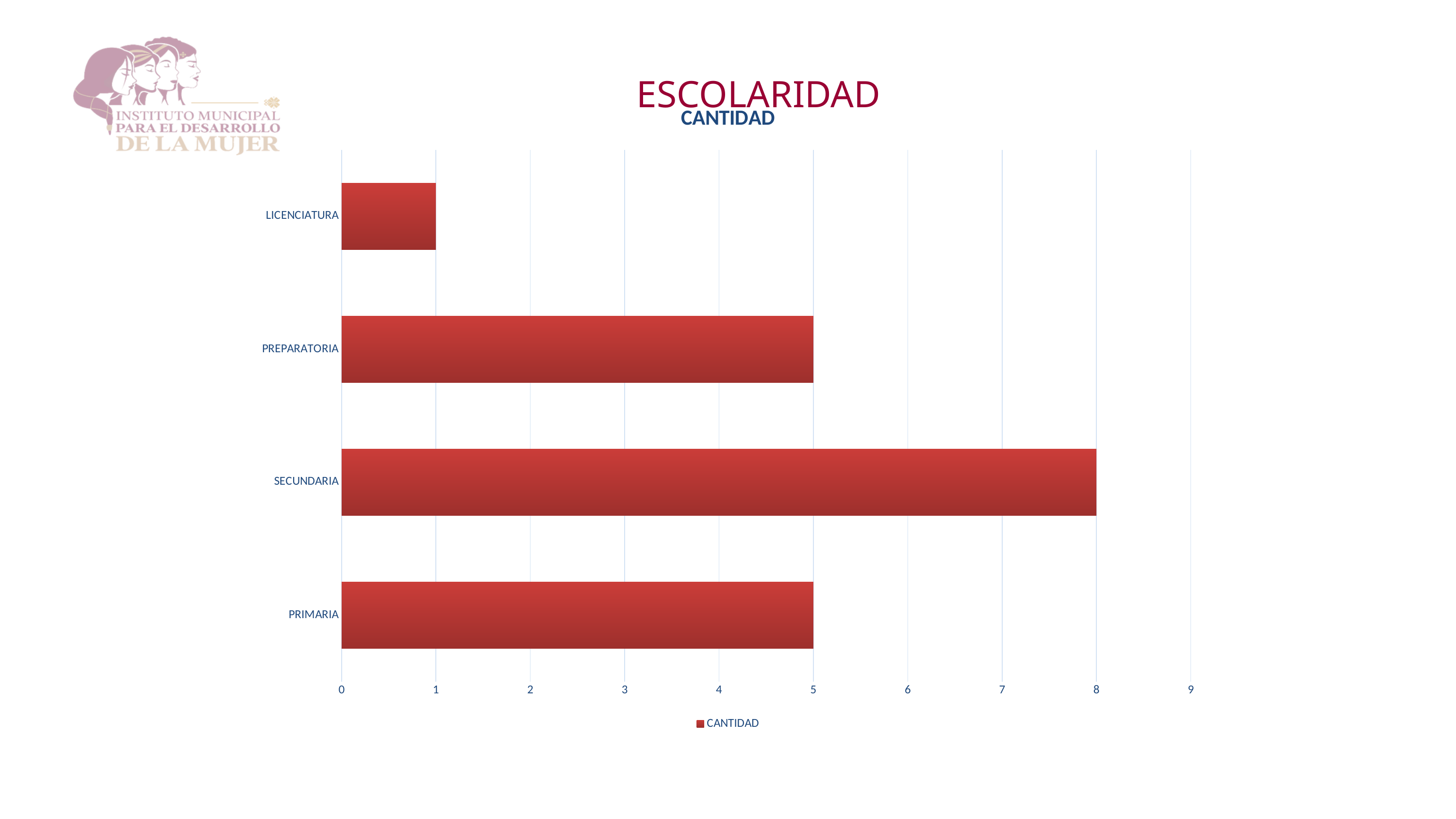
What is the value for PRIMARIA? 5 Is the value for SECUNDARIA greater or less than 6? greater Which is larger, the value for SECUNDARIA or the value for PREPARATORIA? SECUNDARIA What is the title of the chart? CANTIDAD How many categories are shown in the chart? 4 What kind of chart is shown on the slide? bar chart What is the value for LICENCIATURA? 1 Which category has the highest value? SECUNDARIA What is the difference between the values for SECUNDARIA and LICENCIATURA? 7 Which category has the lowest value? LICENCIATURA What is the value for SECUNDARIA? 8 What is the value for PREPARATORIA? 5